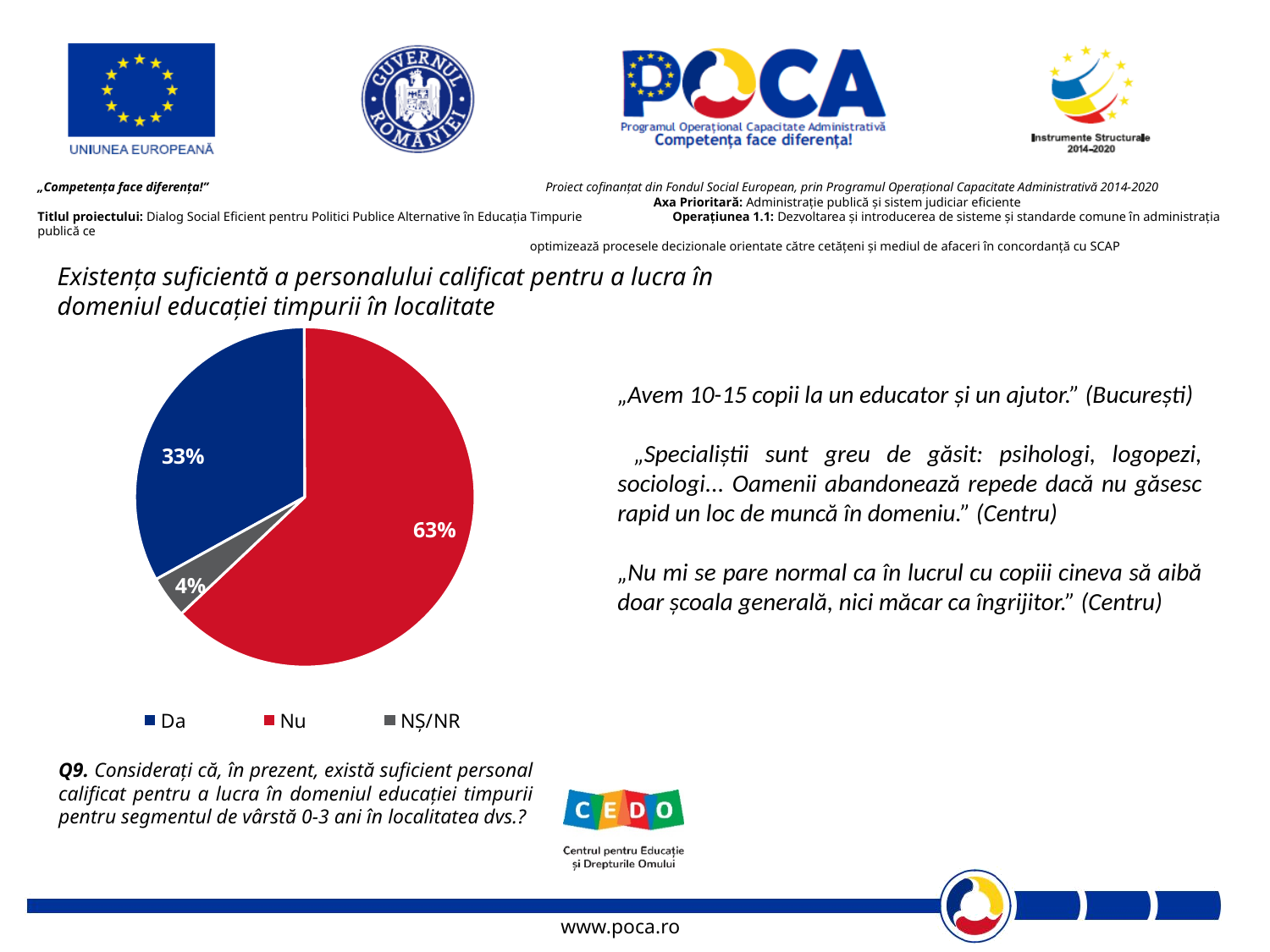
What is the difference in percentage points between "Nu" and "Da"? 30 What percentage of respondents answered "Da"? 33% What kind of chart is shown on the slide? pie chart What is the title of the chart? Existența suficientă a personalului calificat pentru a lucra în domeniul educației timpurii în localitate What is the combined share of "Da" and "NȘ/NR"? 37% Which response has the smallest share of the pie? NȘ/NR What percentage of respondents answered "NȘ/NR"? 4% How many categories does the legend list? 3 What colour is the "Nu" slice? red Which response has the largest share of the pie? Nu Which is larger, the share for "Da" or the share for "NȘ/NR"? Da What percentage of respondents answered "Nu"? 63%